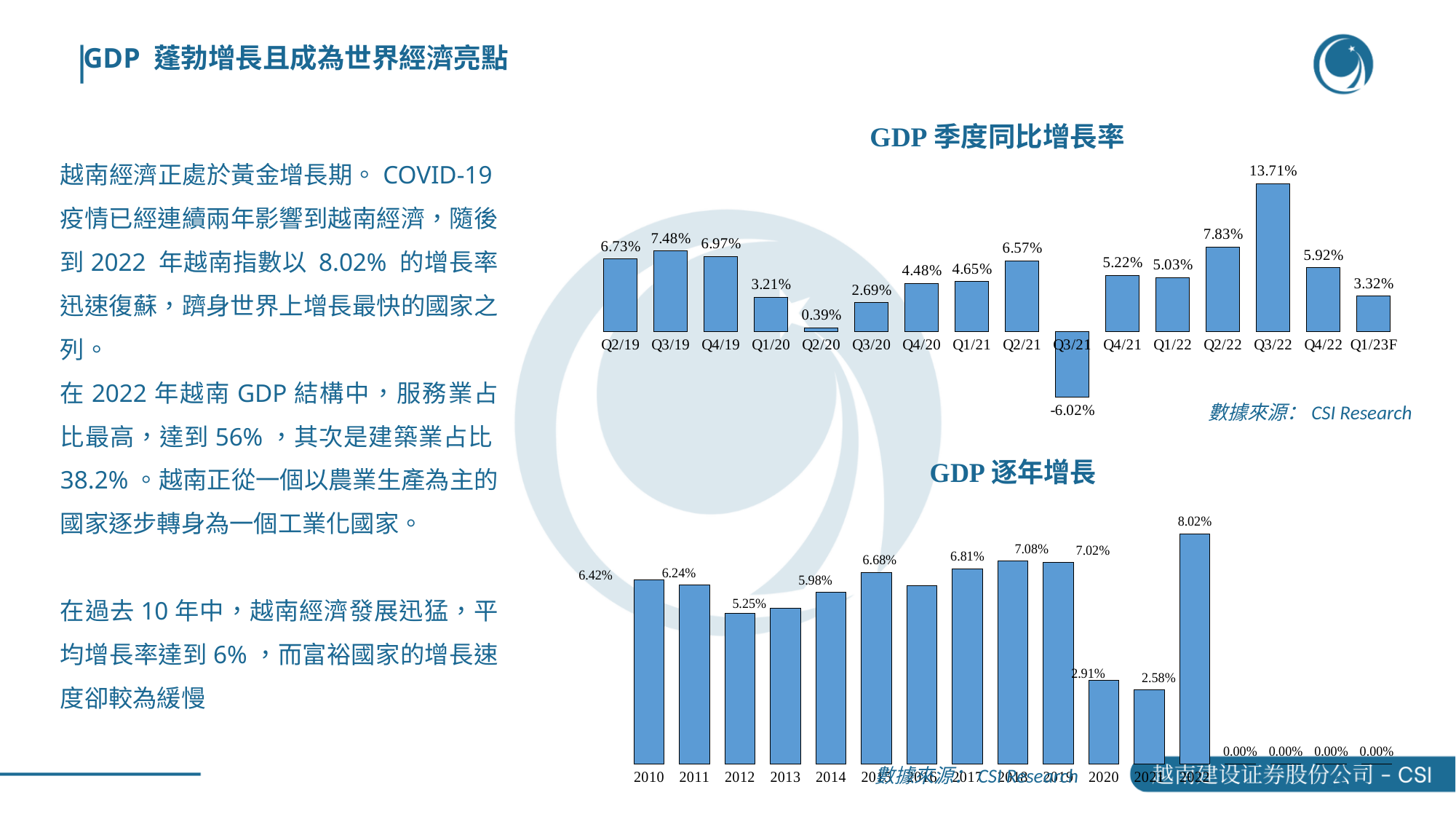
In the GDP 季度同比增長率 chart, which quarter has the highest value? Q3/22 In the GDP 季度同比增長率 chart, what is the value for Q2/20? 0.39% In the GDP 季度同比增長率 chart, what is the value for Q3/22? 13.71% In the GDP 季度同比增長率 chart, which is larger, the value for Q3/19 or Q4/19? Q3/19 What kind of chart is the GDP 逐年增長 chart? bar chart In the GDP 逐年增長 chart, what is the value for 2021? 2.58% How many quarters are plotted in the GDP 季度同比增長率 chart? 16 In the GDP 季度同比增長率 chart, do the values rise or fall from Q2/19 to Q2/20? fall In the GDP 季度同比增長率 chart, which quarter has the lowest value? Q3/21 In the GDP 季度同比增長率 chart, what is the difference between the values for Q3/22 and Q2/22? 5.88% In the GDP 逐年增長 chart, which year has the highest value? 2022 In the GDP 逐年增長 chart, what is the value for 2022? 8.02%